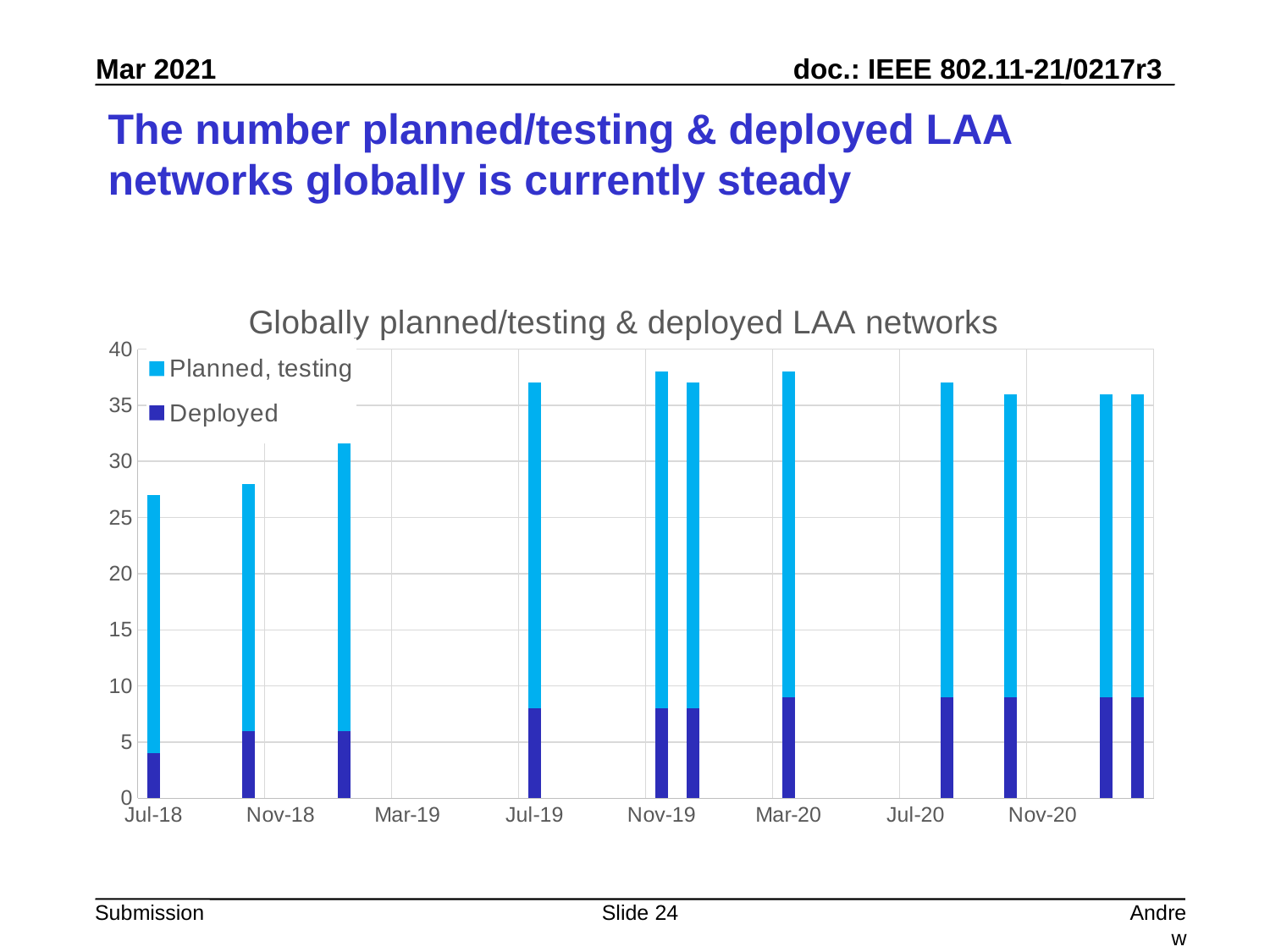
What kind of chart is shown on the slide? Stacked bar chart Is the total height of the Jul-18 bar greater or less than 25? greater Is the total height of the Nov-19 bar greater or less than 35? greater How many series does the legend list? 2 Is the Deployed value for Jul-18 greater or less than 5? less Do the total bar heights rise or fall from Jul-18 to Jul-19? rise What are the two series named in the legend? Planned, testing; Deployed How many stacked bars are plotted in the chart? 11 Which bar has the larger total, Jul-18 or Nov-19? Nov-19 What is the title of the chart? Globally planned/testing & deployed LAA networks